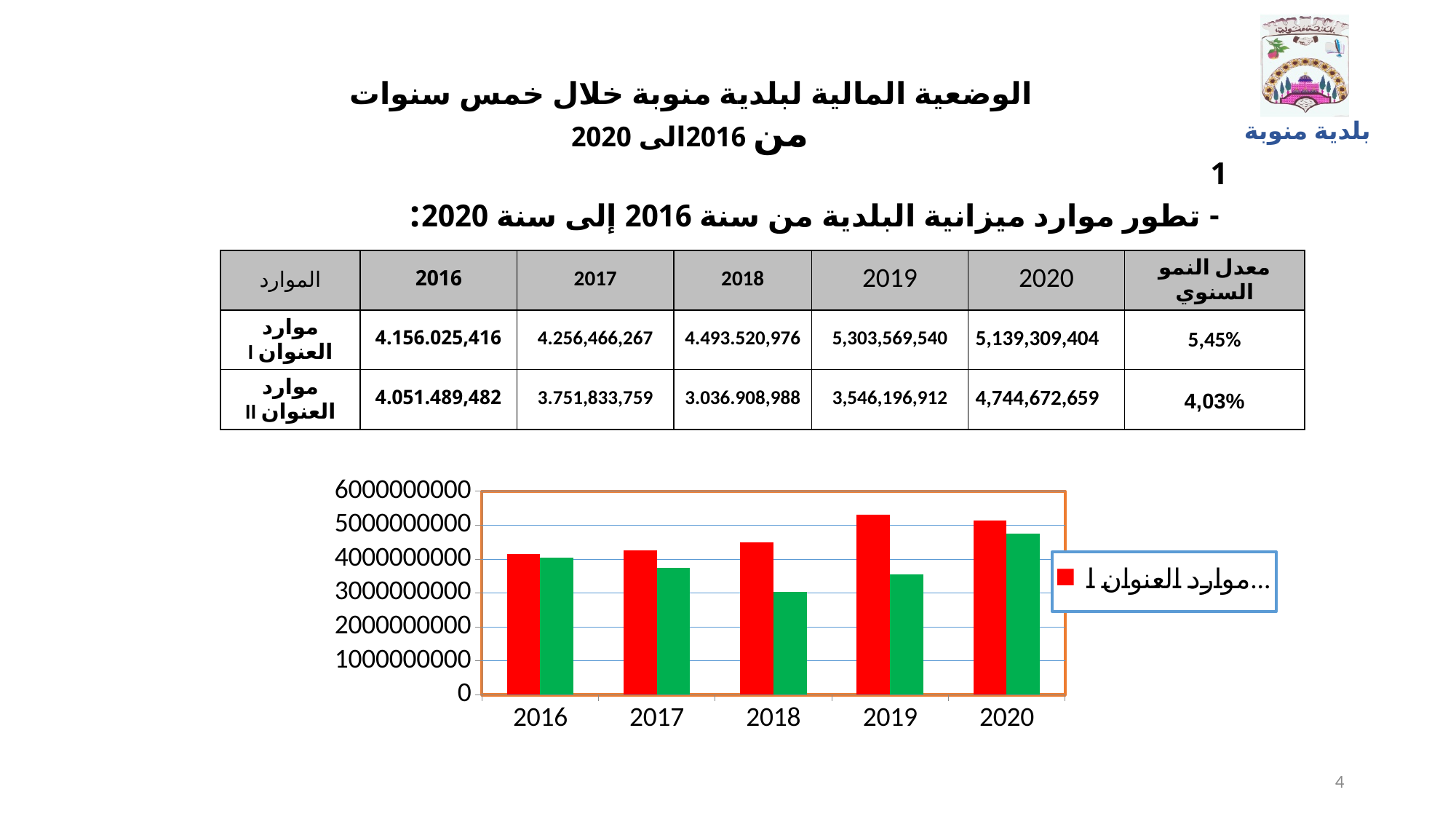
In which year is the red bar the tallest? 2019 In 2019, which bar is taller, the red one or the green one? the red one Is the red bar for 2018 greater or less than 4000000000? greater In which year is the green bar the shortest? 2018 In which year is the green bar the tallest? 2020 Is the green bar for 2020 greater or less than 5000000000? less What kind of chart is shown at the bottom of the slide? bar chart How many bars are plotted for each year in the chart? 2 Do the green bars rise or fall from 2018 to 2020? rise Is the red bar for 2019 greater or less than 5000000000? greater How many years are shown on the x axis of the chart? 5